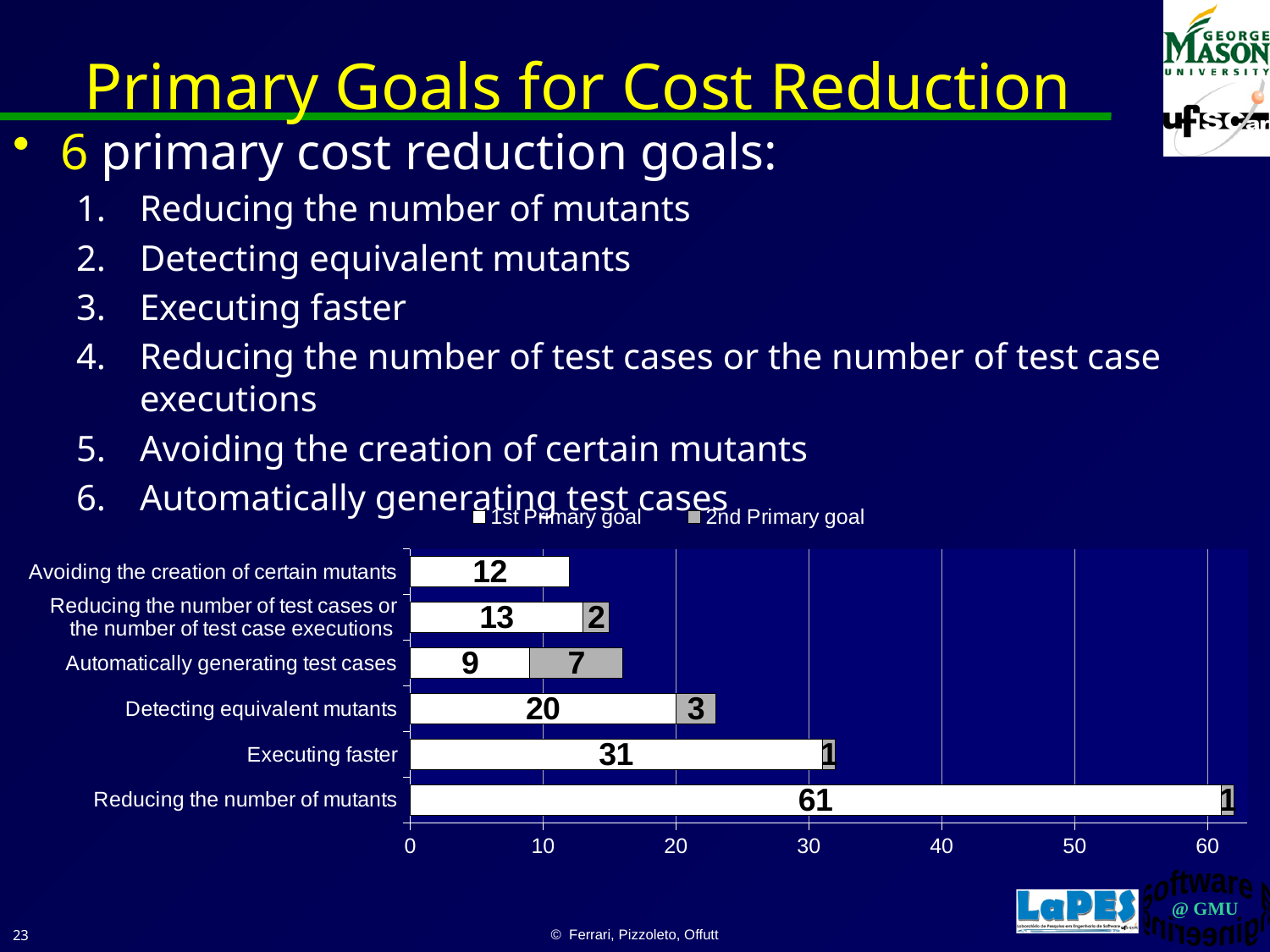
Which category has the lowest 1st Primary goal value? Automatically generating test cases What is the difference between the 1st Primary goal values for Reducing the number of mutants and Executing faster? 30 What is the 2nd Primary goal value for Detecting equivalent mutants? 3 What is the 1st Primary goal value for Reducing the number of mutants? 61 How many categories are plotted in the chart? 6 Which is larger: the 1st Primary goal value for Detecting equivalent mutants or for Reducing the number of test cases or the number of test case executions? Detecting equivalent mutants Which category has the highest 1st Primary goal value? Reducing the number of mutants How many series does the chart legend list? 2 What is the 2nd Primary goal value for Automatically generating test cases? 7 What kind of chart is shown on the slide? bar chart What is the total of the stacked bar for Automatically generating test cases? 16 What is the 1st Primary goal value for Executing faster? 31